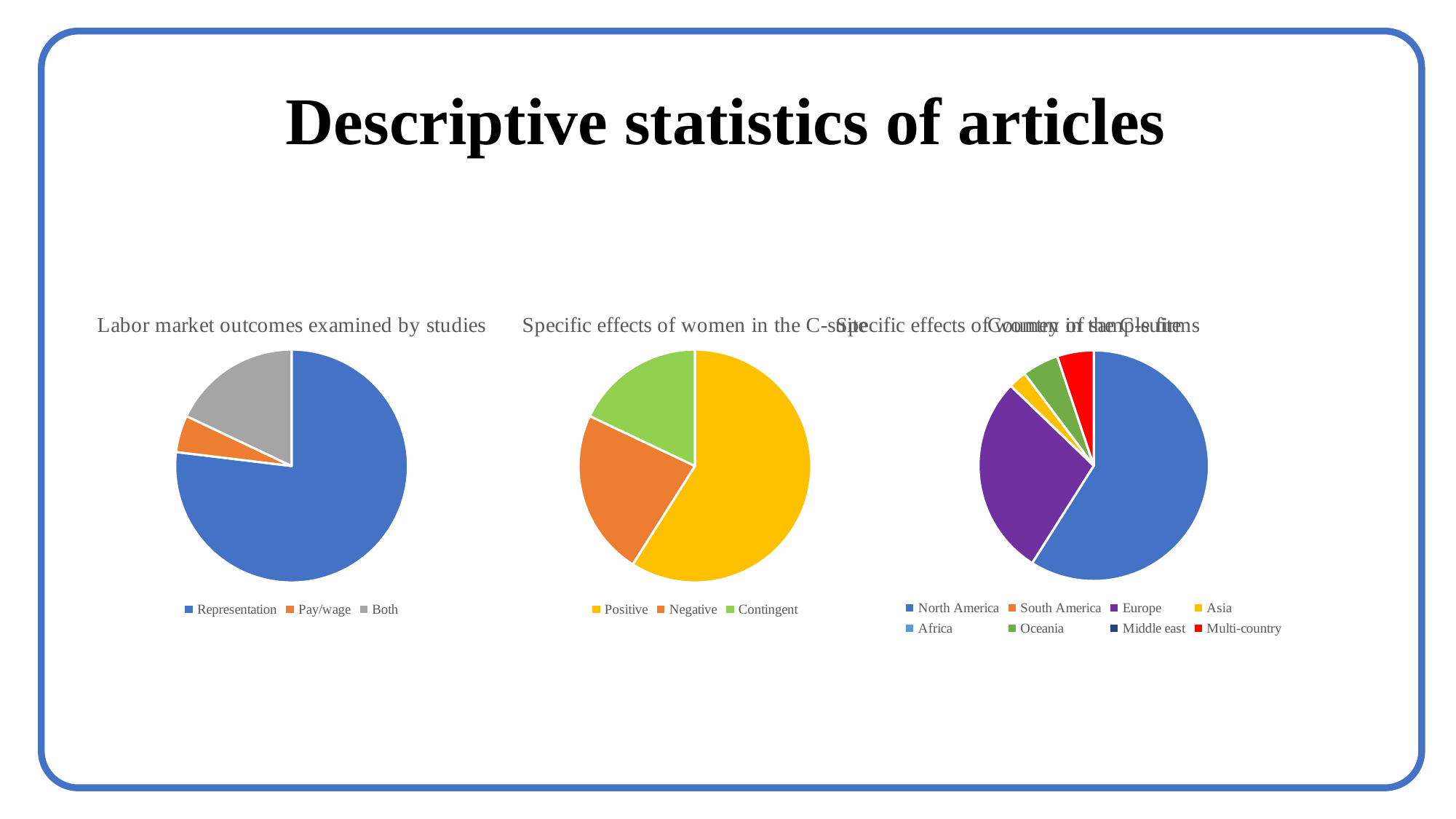
In the right chart, 'Country of sample firms', which category has the largest slice? North America In the middle chart, 'Specific effects of women in the C-suite', which colour represents the Positive category? Yellow What type of chart is the left chart, 'Labor market outcomes examined by studies'? Pie chart How many categories does the legend of the middle chart, 'Specific effects of women in the C-suite', list? 3 In the left chart, 'Labor market outcomes examined by studies', which category has the smallest slice? Pay/wage In the right chart, 'Country of sample firms', which slice is larger: Europe or Oceania? Europe In the left chart, 'Labor market outcomes examined by studies', which category has the largest slice? Representation In the left chart, 'Labor market outcomes examined by studies', which slice is larger: Both or Pay/wage? Both How many categories does the legend of the left chart, 'Labor market outcomes examined by studies', list? 3 How many categories does the legend of the right chart, 'Country of sample firms', list? 8 In the middle chart, 'Specific effects of women in the C-suite', which category has the smallest slice? Contingent In the middle chart, 'Specific effects of women in the C-suite', which category has the largest slice? Positive